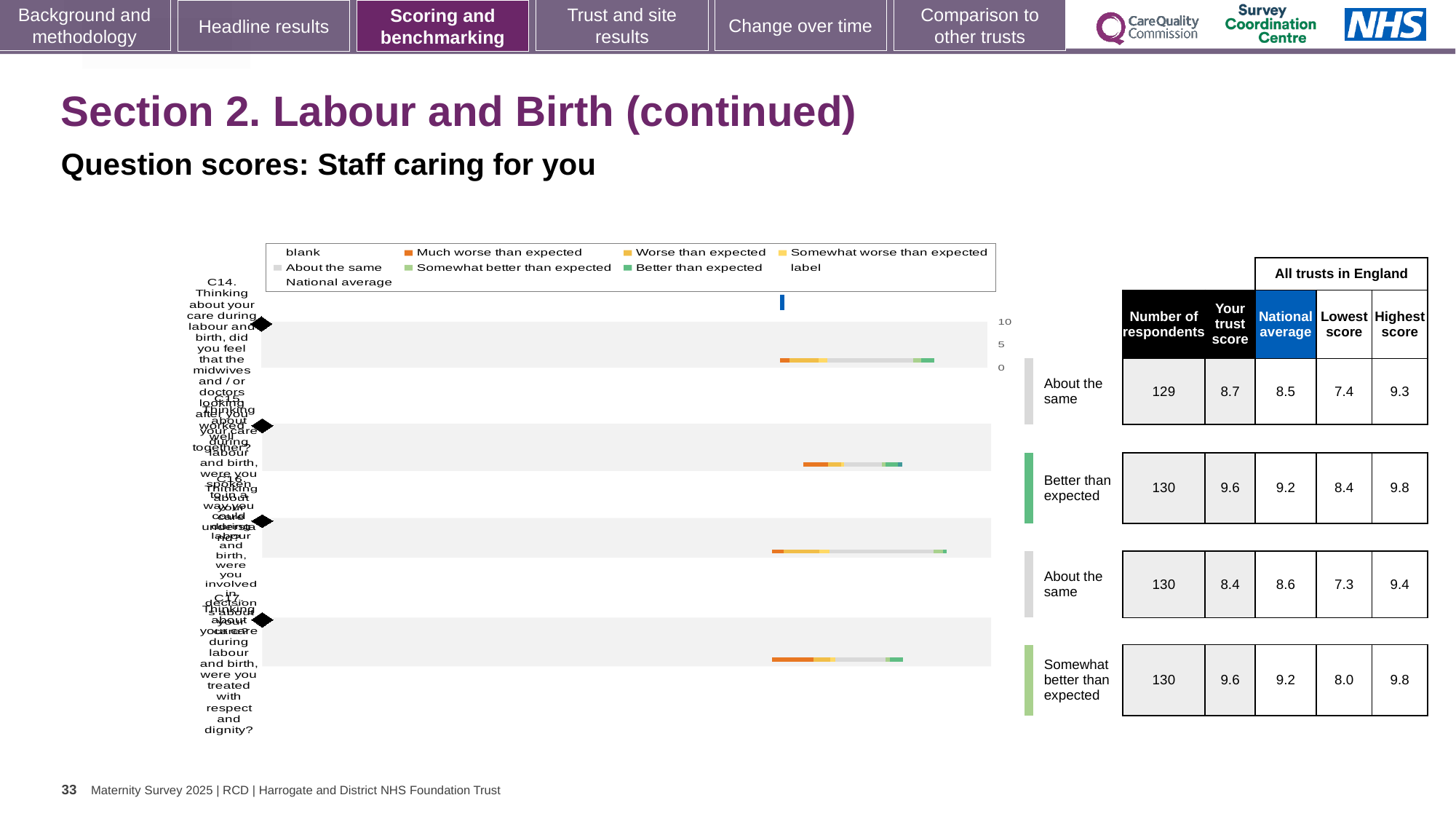
In the legend, what colour represents 'Much worse than expected'? orange In the table beside the chart, what is the difference between the highest and lowest scores for the row labelled 'Somewhat better than expected'? 1.8 In the table beside the chart, what is the difference between the trust score and the national average for the row labelled 'Better than expected'? 0.4 In the table beside the chart, which row has the lowest trust score? the third row (About the same, 8.4) In the table beside the chart, what is the lowest score for the third row (About the same, 130 respondents)? 7.3 In the table beside the chart, is the trust score for the first row (8.7) larger or smaller than its national average (8.5)? larger In the table beside the chart, what is the trust score for the row labelled 'Better than expected'? 9.6 How many questions (C14 to C17) are plotted in the chart? 4 What kind of chart is shown on the slide? bar chart In the table beside the chart, what is the national average for the row labelled 'Somewhat better than expected'? 9.2 In the table beside the chart, what is the number of respondents for the first row (About the same)? 129 In the table beside the chart, what is the highest score for the row labelled 'Better than expected'? 9.8